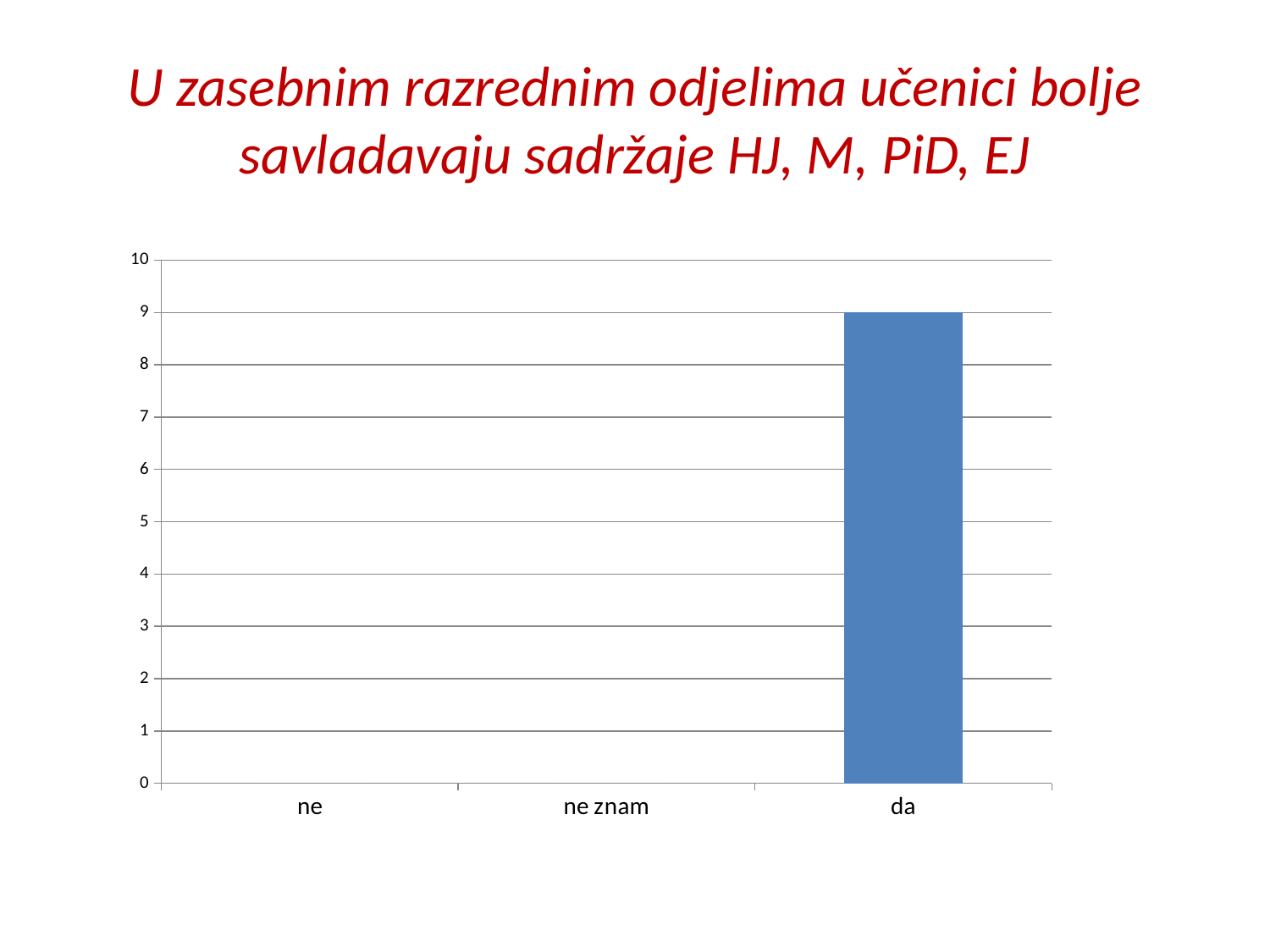
How many categories are shown on the x axis of the chart? 3 Is the value for "ne" greater or less than 1? less Which category has the highest value? da Is the value for "ne znam" greater or less than 1? less Is the value for "da" greater or less than 5? greater What colour is the bar for "da"? blue What is the value for the category "da"? 9 Which is larger, the value for "da" or the value for "ne"? da What kind of chart is shown on the slide? bar chart What is the highest value shown on the y axis of the chart? 10 What is the label of the middle category on the x axis? ne znam What is the value for the category "ne"? 0